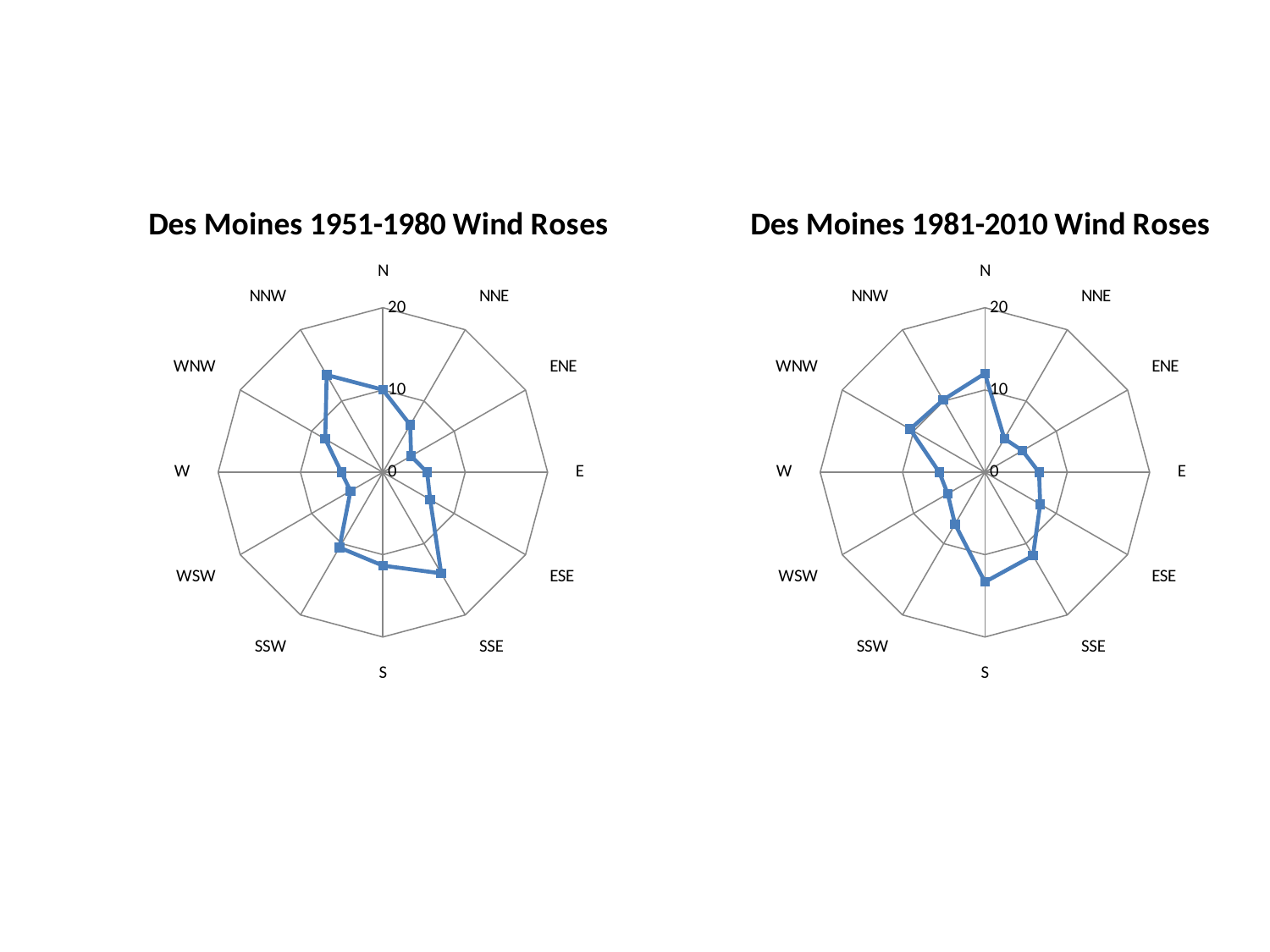
In the "Des Moines 1951-1980 Wind Roses" chart, is the value for ENE greater or less than 10? less How many compass directions (categories) are plotted on the "Des Moines 1981-2010 Wind Roses" chart? 12 In the "Des Moines 1981-2010 Wind Roses" chart, is the value for S greater or less than 10? greater What type of chart is the "Des Moines 1951-1980 Wind Roses" chart? Radar chart In the "Des Moines 1981-2010 Wind Roses" chart, which is larger, the value for S or the value for NNE? S What is the maximum value shown on the radial axis of the "Des Moines 1951-1980 Wind Roses" chart? 20 In the "Des Moines 1951-1980 Wind Roses" chart, is the value for W greater or less than 10? less In the "Des Moines 1951-1980 Wind Roses" chart, which is larger, the value for SSE or the value for W? SSE How many charts are shown on the slide? 2 In the "Des Moines 1981-2010 Wind Roses" chart, which direction has the highest value? S